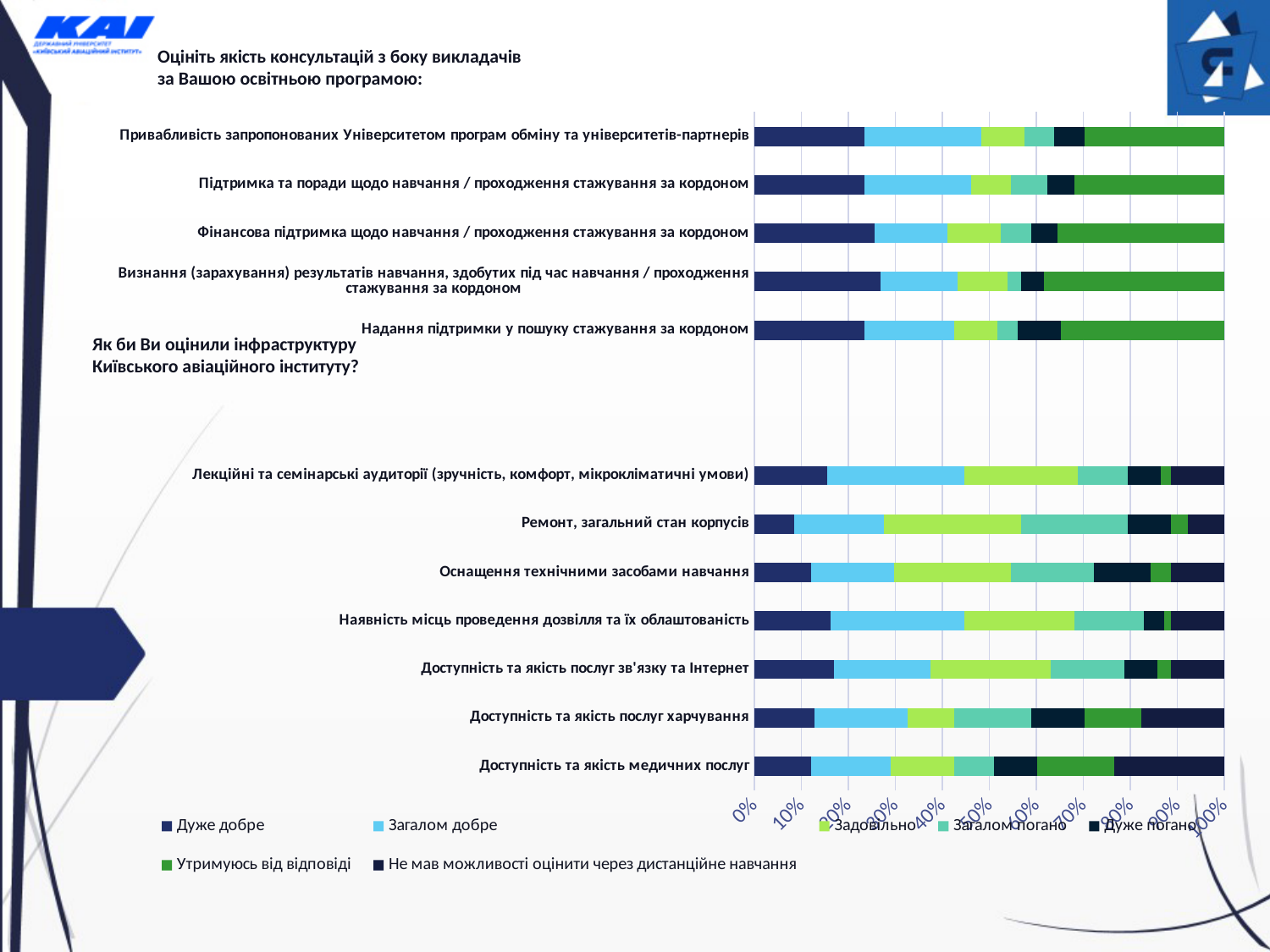
How many categories are plotted in the bottom chart ("Як би Ви оцінили інфраструктуру Київського авіаційного інституту?")? 7 In the bottom chart ("Як би Ви оцінили інфраструктуру"), which category has the largest "Не мав можливості оцінити через дистанційне навчання" segment? Доступність та якість медичних послуг In the bottom chart ("Як би Ви оцінили інфраструктуру"), which category has the smallest "Дуже добре" segment? Ремонт, загальний стан корпусів In the top chart ("Оцініть якість консультацій з боку викладачів"), is the "Дуже добре" share for "Привабливість запропонованих Університетом програм обміну та університетів-партнерів" greater or less than 30%? less What kind of chart is the top chart on the slide ("Оцініть якість консультацій з боку викладачів за Вашою освітньою програмою")? Stacked bar chart Which legend entry is shown in green on the slide? Утримуюсь від відповіді What is the highest value shown on the percentage axis of the charts? 100% In the bottom chart ("Як би Ви оцінили інфраструктуру"), is the "Дуже добре" share for "Ремонт, загальний стан корпусів" greater or less than 20%? less In the bottom chart ("Як би Ви оцінили інфраструктуру"), is the "Дуже добре" segment larger for "Лекційні та семінарські аудиторії" or for "Ремонт, загальний стан корпусів"? Лекційні та семінарські аудиторії How many categories are plotted in the top chart ("Оцініть якість консультацій з боку викладачів")? 5 How many series does the legend at the bottom of the slide list? 7